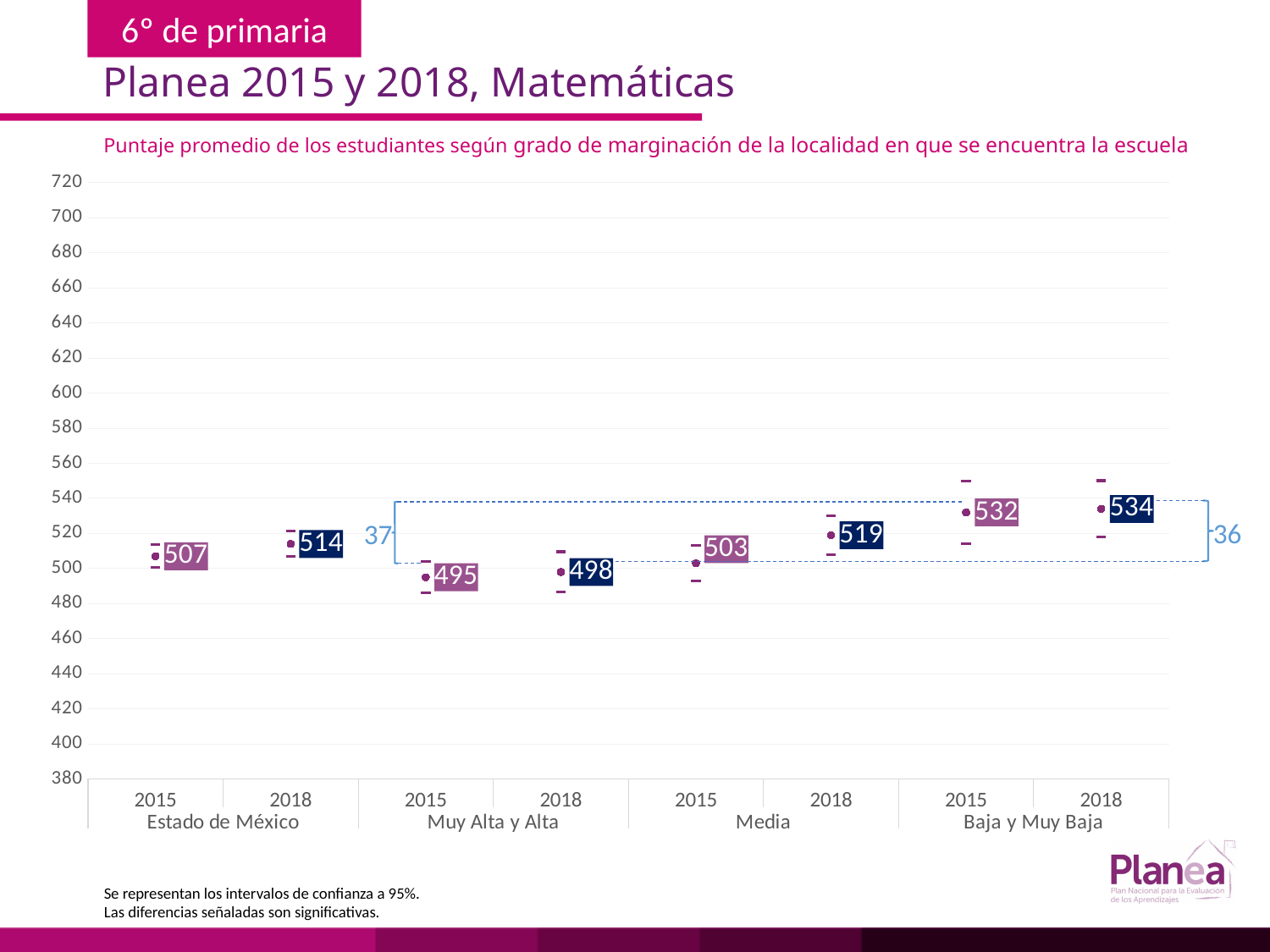
How many data points are plotted on the chart? 8 Which group and year has the lowest average score? Muy Alta y Alta, 2015 Which is larger, the 2018 score for Estado de México or the 2018 score for Media? Media (519) What do the short horizontal marks above and below each point represent? 95% confidence intervals What is the difference between the 2018 scores of Baja y Muy Baja and Muy Alta y Alta? 36 What is the 2015 average score for the Muy Alta y Alta group? 495 What is the difference between the 2018 and 2015 scores for the Media group? 16 What is the 2018 average score for the Baja y Muy Baja group? 534 What is the 2018 average score for the Media marginación group? 519 Is the 2015 score for Baja y Muy Baja greater or less than 520? greater What is the 2015 average score for Estado de México? 507 Which group and year has the highest average score? Baja y Muy Baja, 2018